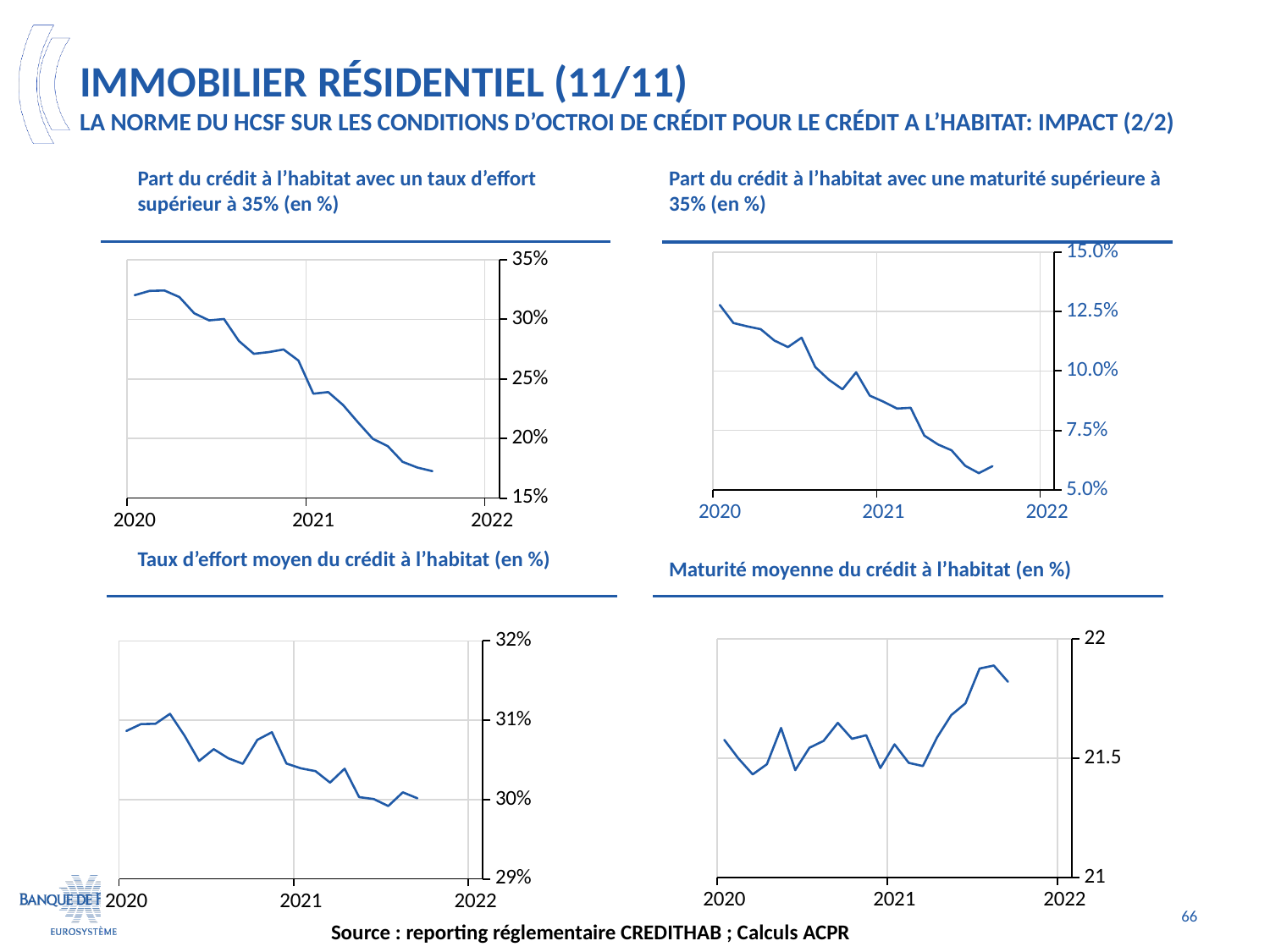
In the top-right chart 'Part du crédit à l'habitat avec une maturité supérieure à 35%', is the last plotted value greater or less than 7.5%? less In the bottom-left chart 'Taux d'effort moyen du crédit à l'habitat (en %)', do the values generally rise or fall from 2020 to 2022? fall In the top-right chart 'Part du crédit à l'habitat avec une maturité supérieure à 35%', do the values rise or fall over the period shown? fall In the top-left chart 'Part du crédit à l'habitat avec un taux d'effort supérieur à 35%', is the value at the start of 2020 greater or less than 30%? greater In the bottom-right chart 'Maturité moyenne du crédit à l'habitat', is the last plotted value greater or less than 21.5? greater In the bottom-right chart 'Maturité moyenne du crédit à l'habitat (en %)', do the values generally rise or fall from 2020 to 2022? rise What kind of chart is the top-left chart titled 'Part du crédit à l'habitat avec un taux d'effort supérieur à 35% (en %)'? line chart How many charts are shown on the slide? 4